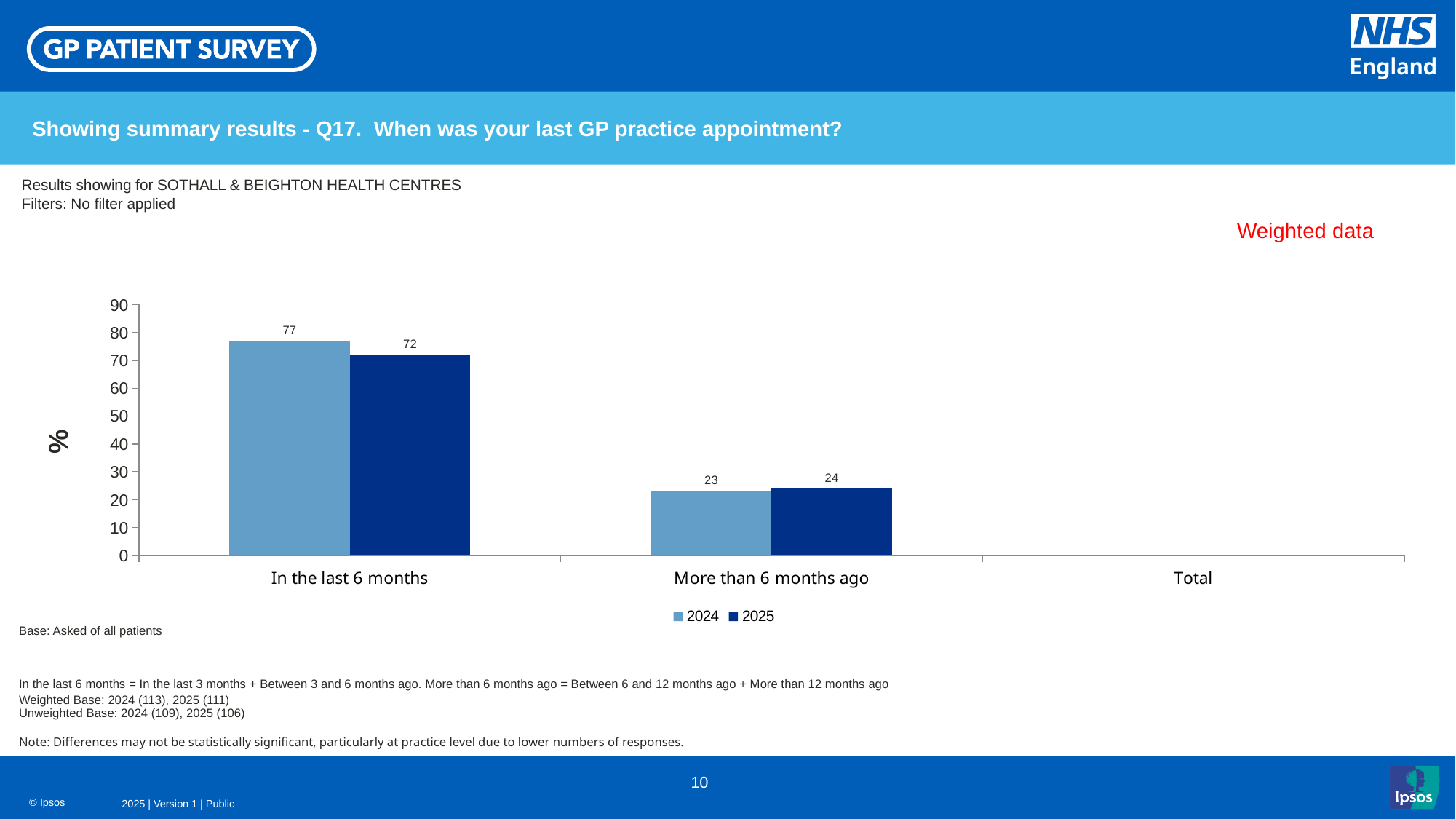
Which category has the highest 2025 value? In the last 6 months What kind of chart is shown on the slide? Bar chart What is the difference between the 2024 and 2025 values for "In the last 6 months"? 5 What is the 2024 value for "In the last 6 months"? 77 What is the 2025 value for "In the last 6 months"? 72 Which is larger for "In the last 6 months": the 2024 value or the 2025 value? 2024 Which series is shown in the darker blue colour? 2025 How many series does the legend list? 2 What is the 2024 value for "More than 6 months ago"? 23 Is the 2024 value for "In the last 6 months" greater or less than 70? greater What is the 2025 value for "More than 6 months ago"? 24 What label is shown on the vertical axis? %